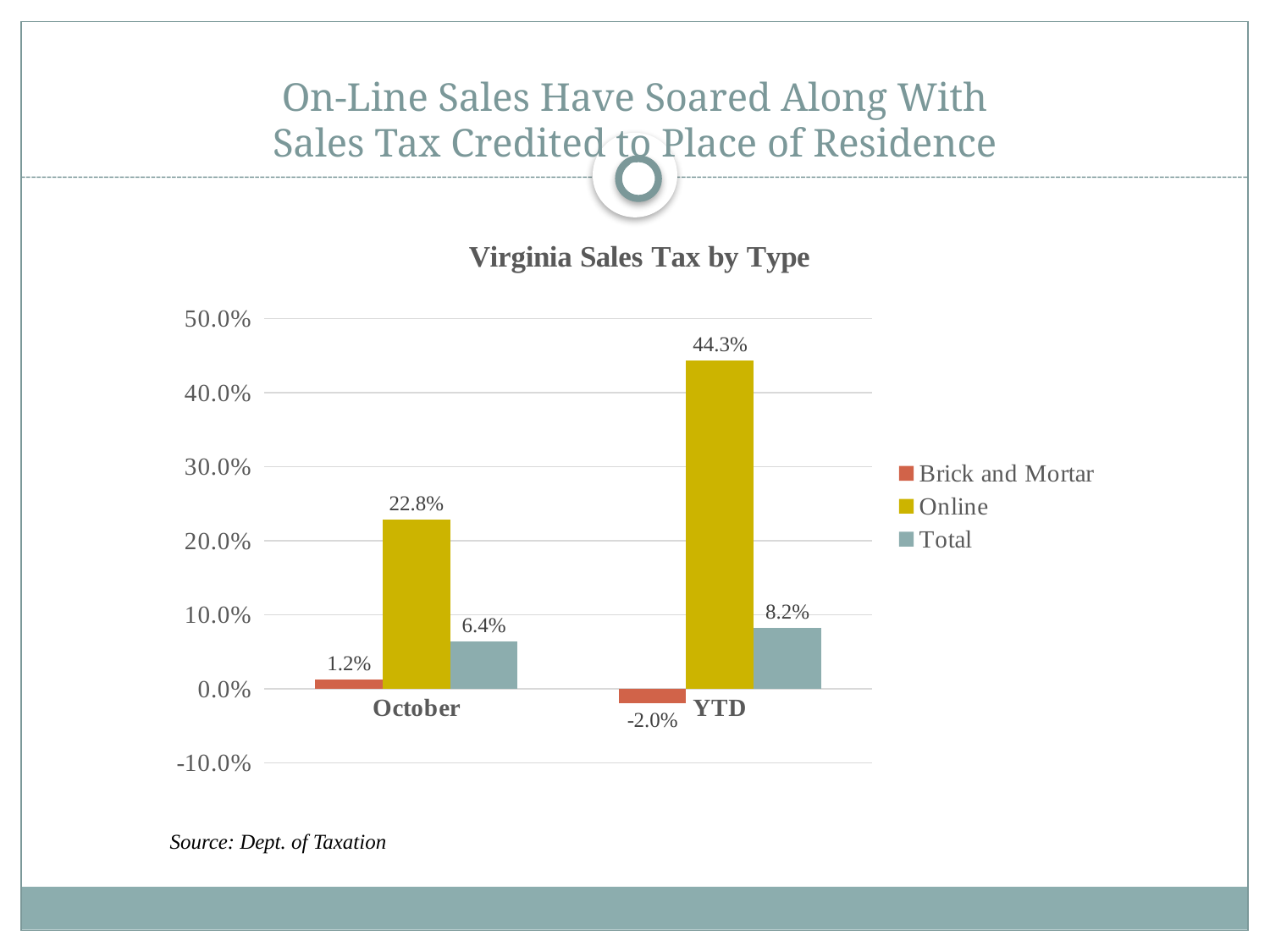
Which is larger, the Total value for October or the Total value for YTD? YTD How many categories are shown on the x axis? 2 What is the Online value for October? 22.8% What is the Total value for October? 6.4% What is the difference between the Online values for YTD and October? 21.5% Which series has the lowest value for October? Brick and Mortar How many series does the legend list? 3 What kind of chart is shown on the slide? bar chart Which series has the highest value for YTD? Online What is the Brick and Mortar value for YTD? -2.0% What is the Online value for YTD? 44.3% Is the Online value for YTD greater or less than 40.0%? greater